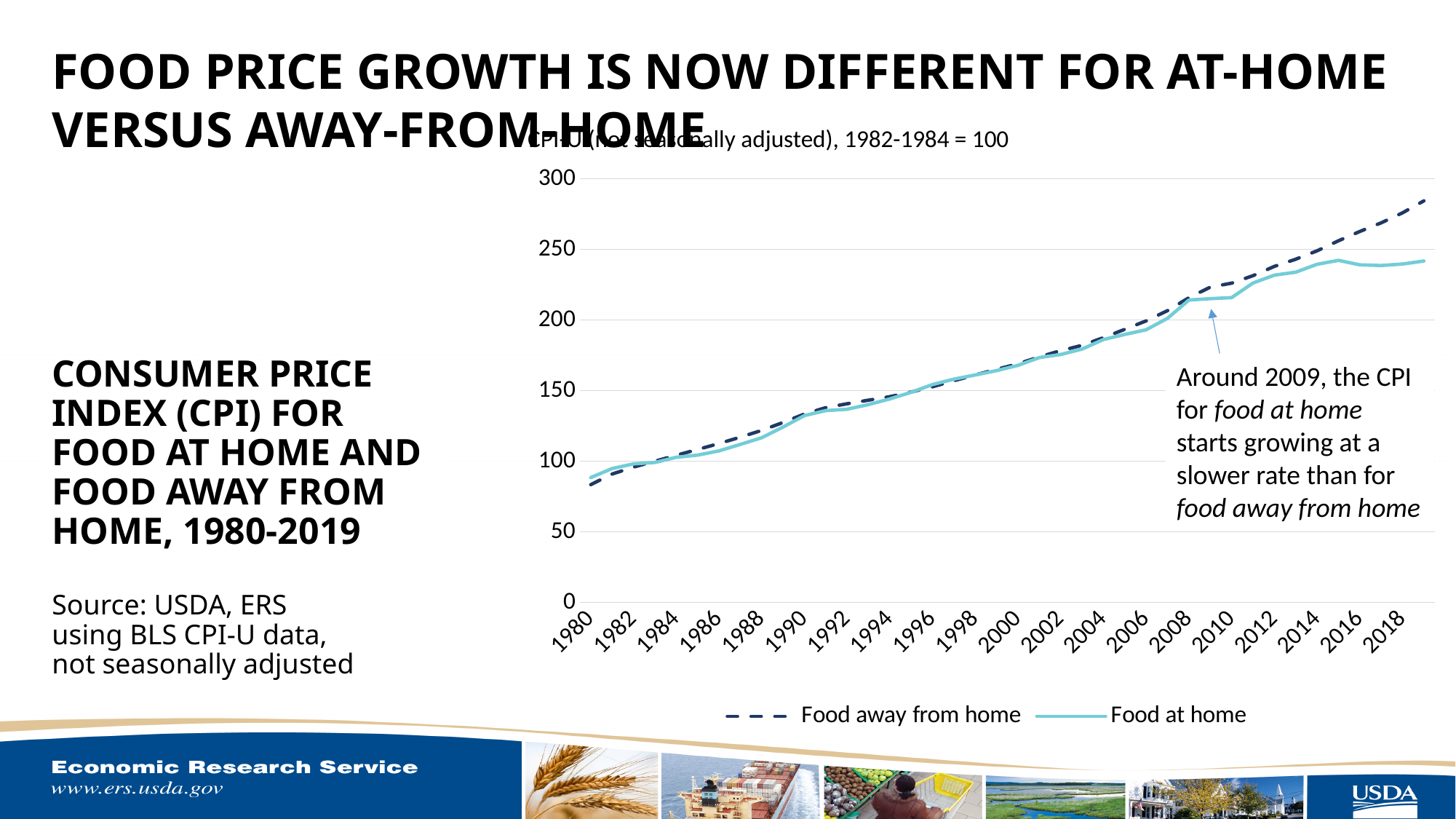
How many series does the chart legend list? 2 In 2018, which series has the higher value, Food away from home or Food at home? Food away from home Is the value for Food away from home in 2000 greater or less than 150? greater How many year labels are shown on the x axis? 20 Is the value for Food at home in 2018 greater or less than 250? less Is the value for Food at home in 1980 greater or less than 100? less Which series is drawn with a dashed line? Food away from home What kind of chart is shown on the slide? line chart Do the values for Food away from home rise or fall from 1980 to 2018? rise What are the two series named in the chart legend? Food away from home; Food at home